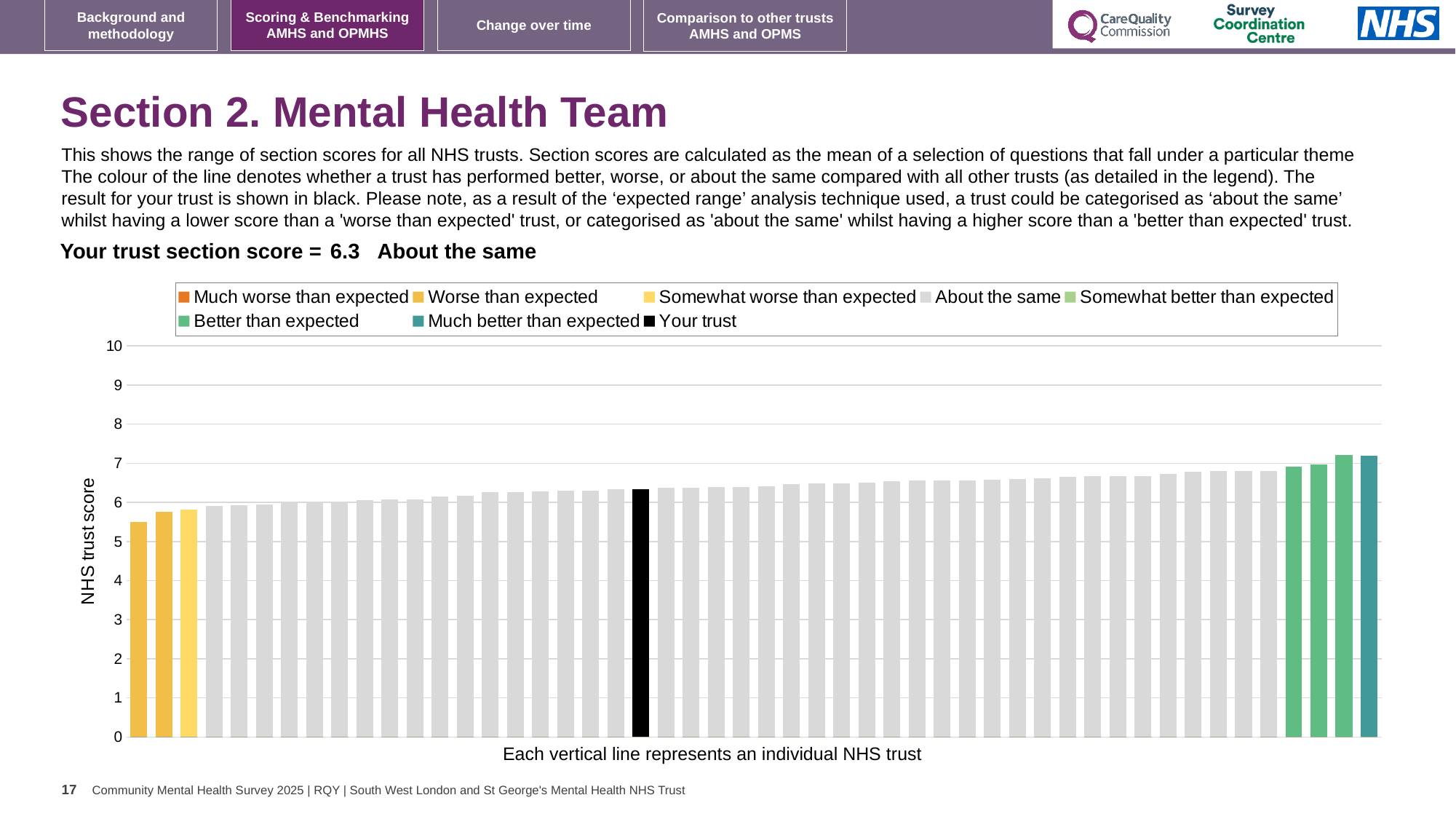
What is the label on the vertical axis of the chart? NHS trust score Which category is your trust placed in for this section? About the same What is the section score for your trust shown on the slide? 6.3 How many entries does the chart legend list? 8 Is the score for the rightmost bar larger or smaller than the score for your trust's black bar? Larger Which bar has the lowest score on the chart? The leftmost bar Is the value for the black bar (your trust) greater or less than 6? greater Is the value for the leftmost bar greater or less than 6? less What kind of chart is shown on the slide? Bar chart What colour is the bar representing your trust? Black Do the bar values rise or fall from left to right along the x axis? Rise Is the value for the rightmost bar greater or less than 7? greater